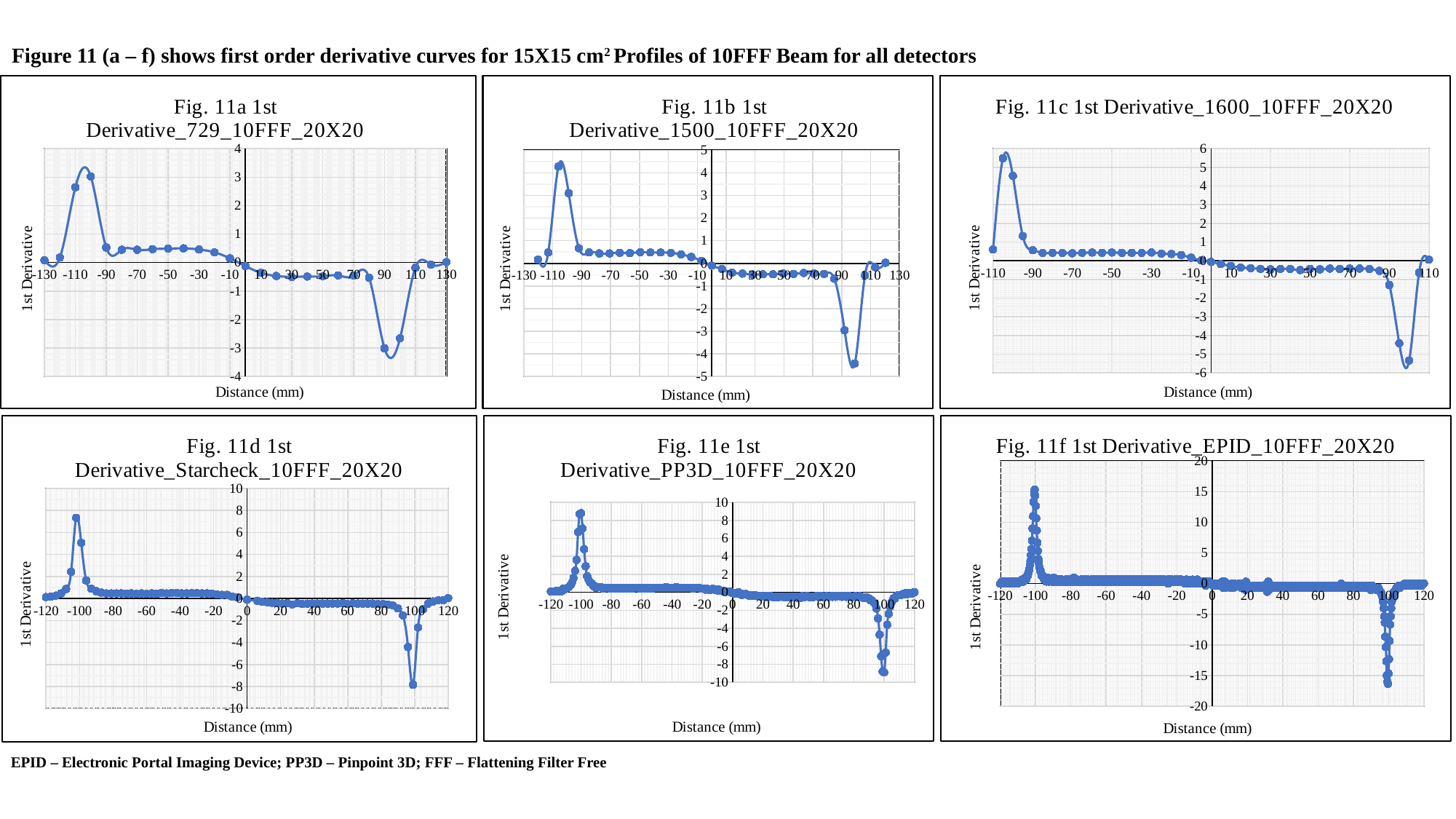
In Fig. 11b 1st Derivative_1500_10FFF_20X20, is the lowest value of the curve near 100 mm greater or less than -4? less In Fig. 11a 1st Derivative_729_10FFF_20X20, which is larger: the value of the curve at about -100 mm or at about 100 mm? at about -100 mm In Fig. 11d 1st Derivative_Starcheck_10FFF_20X20, is the lowest value of the curve near 100 mm greater or less than -6? less What kind of chart is Fig. 11a 1st Derivative_729_10FFF_20X20? line chart In Fig. 11f 1st Derivative_EPID_10FFF_20X20, is the peak value of the curve near -100 mm greater or less than 10? greater How many charts are shown on the slide? 6 What is the x-axis label of Fig. 11d 1st Derivative_Starcheck_10FFF_20X20? Distance (mm) What is the y-axis label of Fig. 11e 1st Derivative_PP3D_10FFF_20X20? 1st Derivative